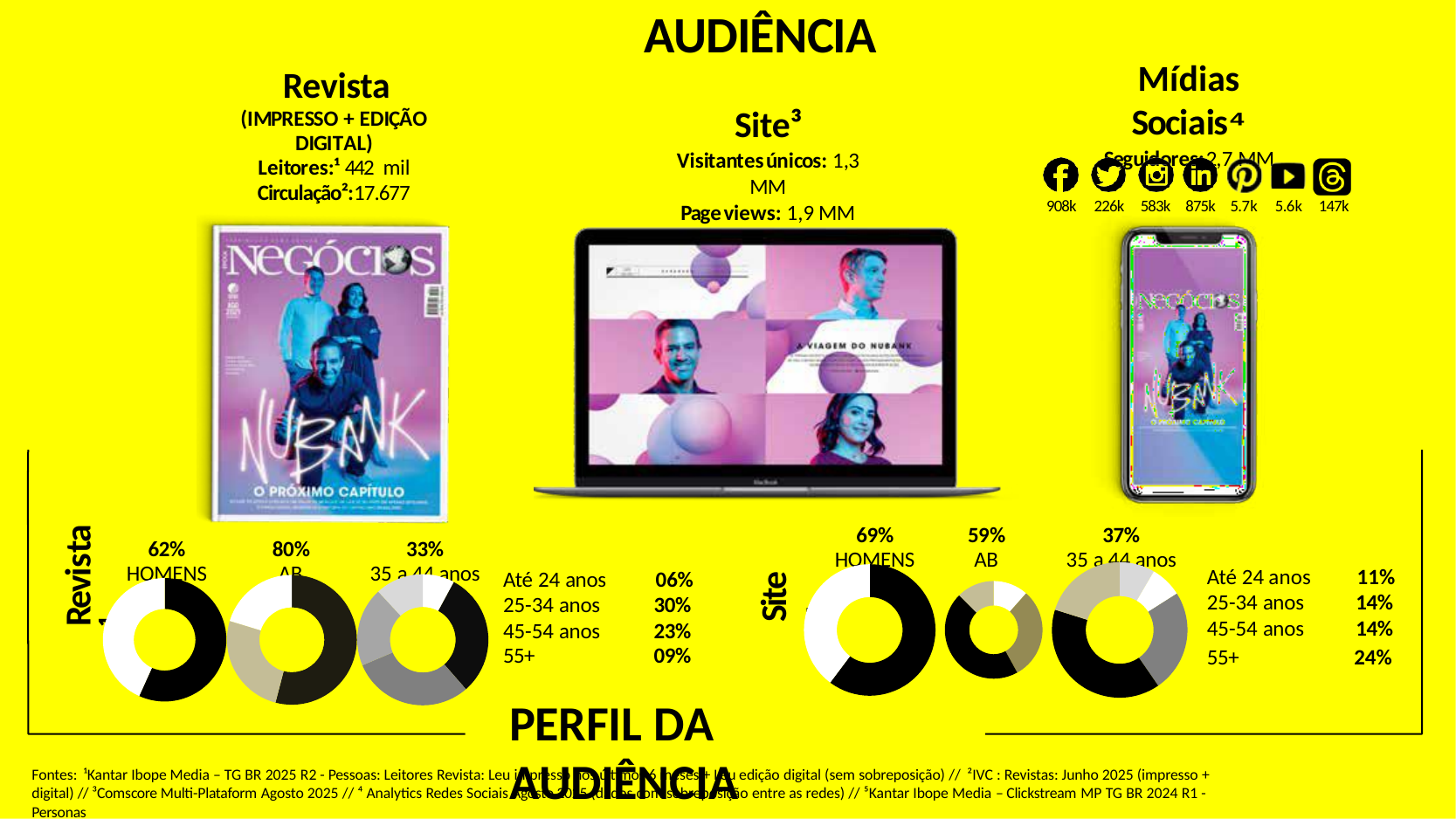
Which has the larger HOMENS share, the Revista profile or the Site profile? Site What is the difference in percentage points between the AB share for Revista and the AB share for Site? 21 percentage points What kind of chart is used to show the audience profile percentages at the bottom of the slide? Donut (pie) chart In the Site profile section, what percentage is shown for AB? 59% In the Site profile section, what percentage is shown for 35 a 44 anos? 37% In the Revista profile section, what percentage is shown for 35 a 44 anos? 33% In the Revista profile section, what percentage is shown for HOMENS? 62% What is the difference in percentage points between the HOMENS share for Site and the HOMENS share for Revista? 7 percentage points In the Revista profile section, what percentage is shown for AB? 80% Which has the larger AB share, the Revista profile or the Site profile? Revista In the Site profile section, what percentage is shown for HOMENS? 69% How many donut charts are shown in the Revista profile section? 3